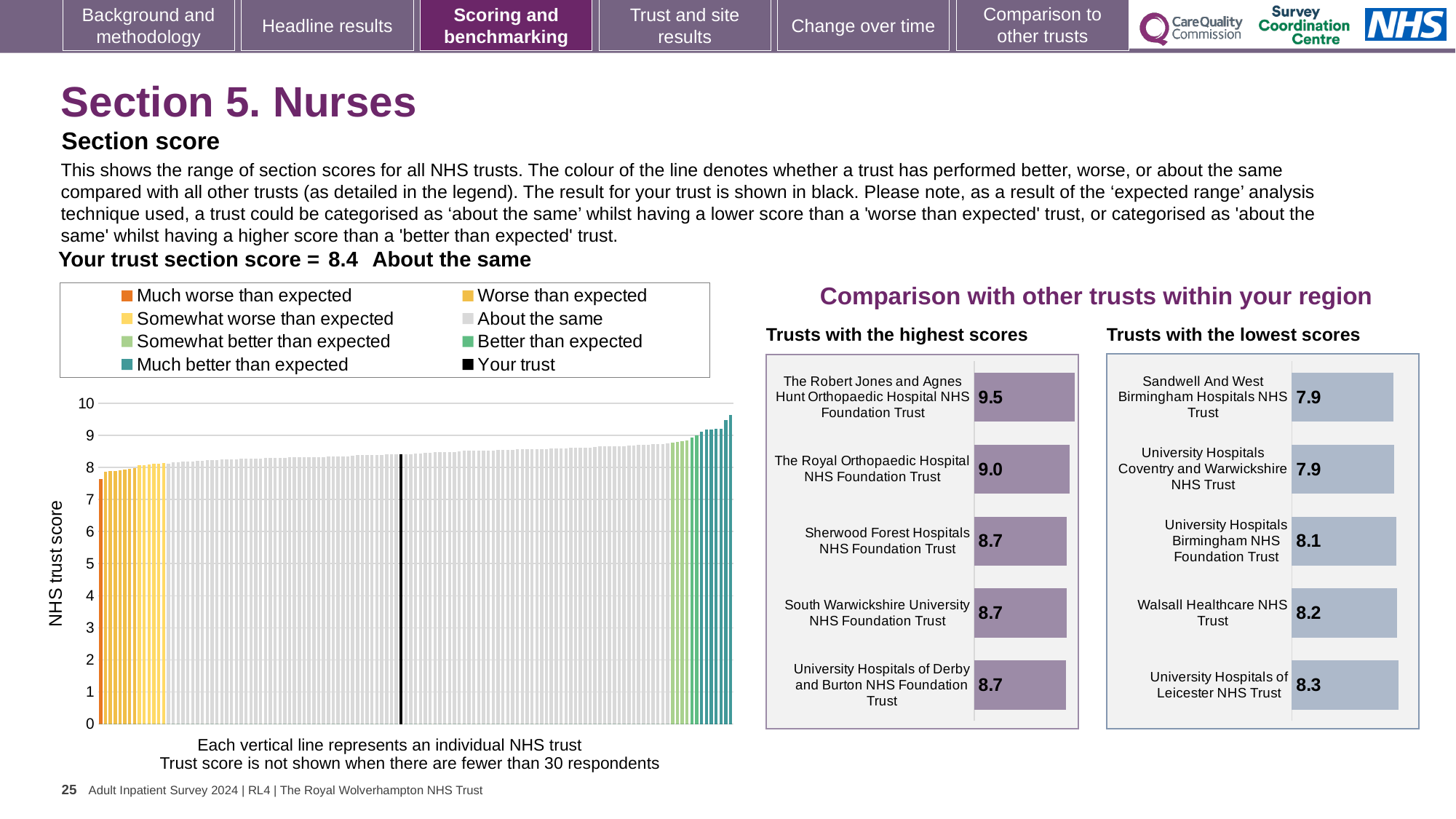
In the 'Trusts with the highest scores' chart, what is the difference between the scores of The Robert Jones and Agnes Hunt Orthopaedic Hospital NHS Foundation Trust and The Royal Orthopaedic Hospital NHS Foundation Trust? 0.5 In the 'Trusts with the lowest scores' chart, what is the difference between the scores of University Hospitals of Leicester NHS Trust and Sandwell And West Birmingham Hospitals NHS Trust? 0.4 What kind of chart is the main NHS trust score chart on the left? bar chart In the 'Trusts with the highest scores' chart, what is the score for The Robert Jones and Agnes Hunt Orthopaedic Hospital NHS Foundation Trust? 9.5 In the 'Trusts with the lowest scores' chart, which has the larger score: University Hospitals Birmingham NHS Foundation Trust or University Hospitals of Leicester NHS Trust? University Hospitals of Leicester NHS Trust In the 'Trusts with the highest scores' chart, which trust has the highest score? The Robert Jones and Agnes Hunt Orthopaedic Hospital NHS Foundation Trust In the 'Trusts with the lowest scores' chart, what is the score for Walsall Healthcare NHS Trust? 8.2 In the main NHS trust score chart on the left, is the value for your trust (the black line) greater or less than 8? greater In the 'Trusts with the lowest scores' chart, which trust has the highest score shown? University Hospitals of Leicester NHS Trust In the 'Trusts with the highest scores' chart, how many trusts are shown? 5 How many entries does the legend of the main NHS trust score chart list? 8 In the main NHS trust score chart on the left, do the values rise or fall from left to right along the x axis? rise